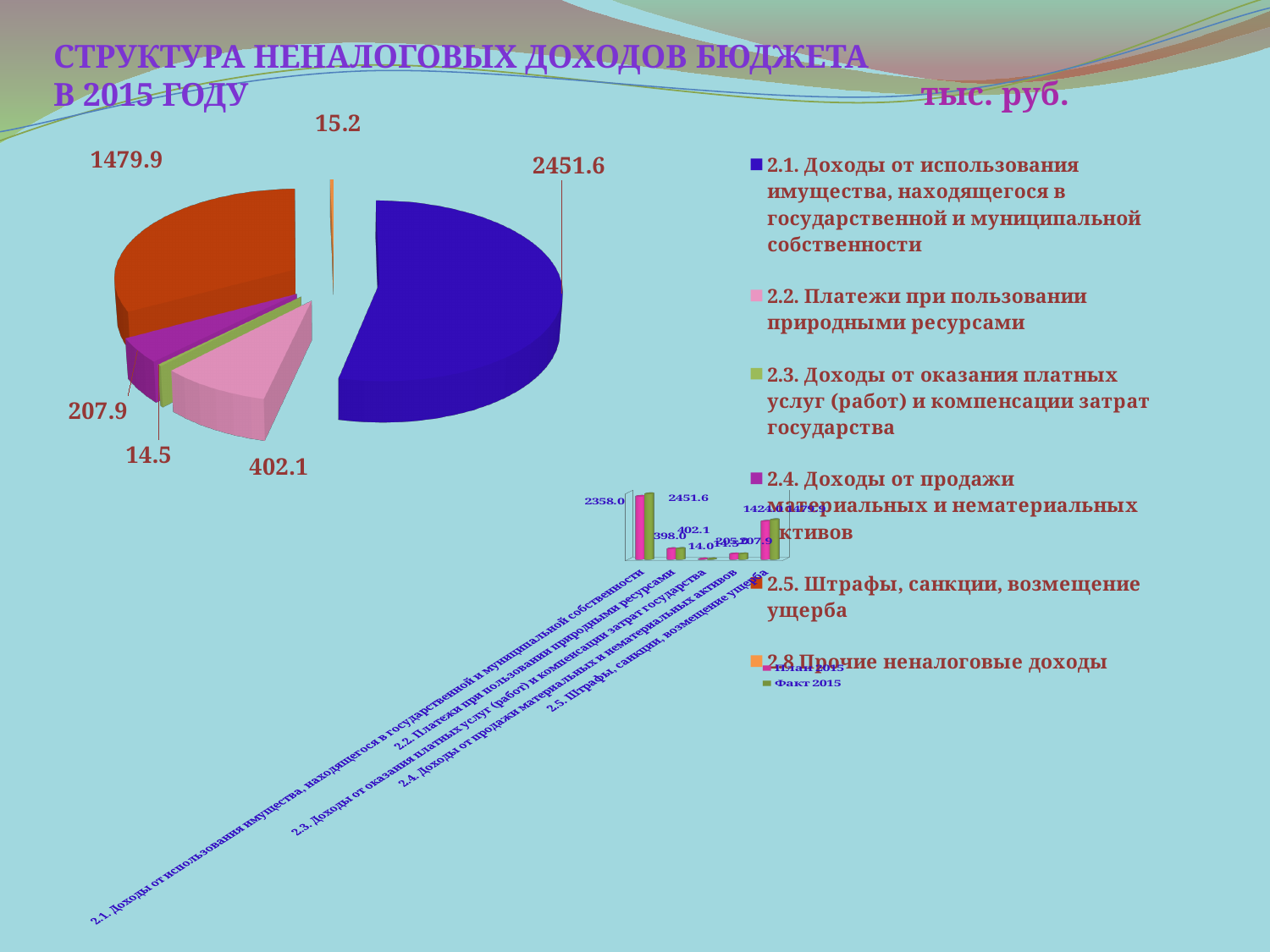
How many series does the legend of the small bar chart at the bottom list? 2 On the pie chart, what is the value for 2.2. Платежи при пользовании природными ресурсами? 402.1 What kind of chart is the large chart on the left of the slide? Pie chart How many categories does the pie chart's legend list? 6 On the pie chart, what is the difference between the values for 2.1 (2451.6) and 2.5 (1479.9)? 971.7 On the pie chart, which is larger: the value for 2.2. Платежи при пользовании природными ресурсами or 2.4. Доходы от продажи материальных и нематериальных активов? 2.2. Платежи при пользовании природными ресурсами On the small bar chart at the bottom, what is the План 2015 value for 2.2. Платежи при пользовании природными ресурсами? 398.0 On the pie chart, what is the value for 2.5. Штрафы, санкции, возмещение ущерба? 1479.9 On the pie chart, what is the value for 2.1. Доходы от использования имущества, находящегося в государственной и муниципальной собственности? 2451.6 On the pie chart, which category has the smallest value? 2.3. Доходы от оказания платных услуг (работ) и компенсации затрат государства What kind of chart is the small chart at the bottom of the slide? Bar chart On the pie chart, which category has the largest value? 2.1. Доходы от использования имущества, находящегося в государственной и муниципальной собственности